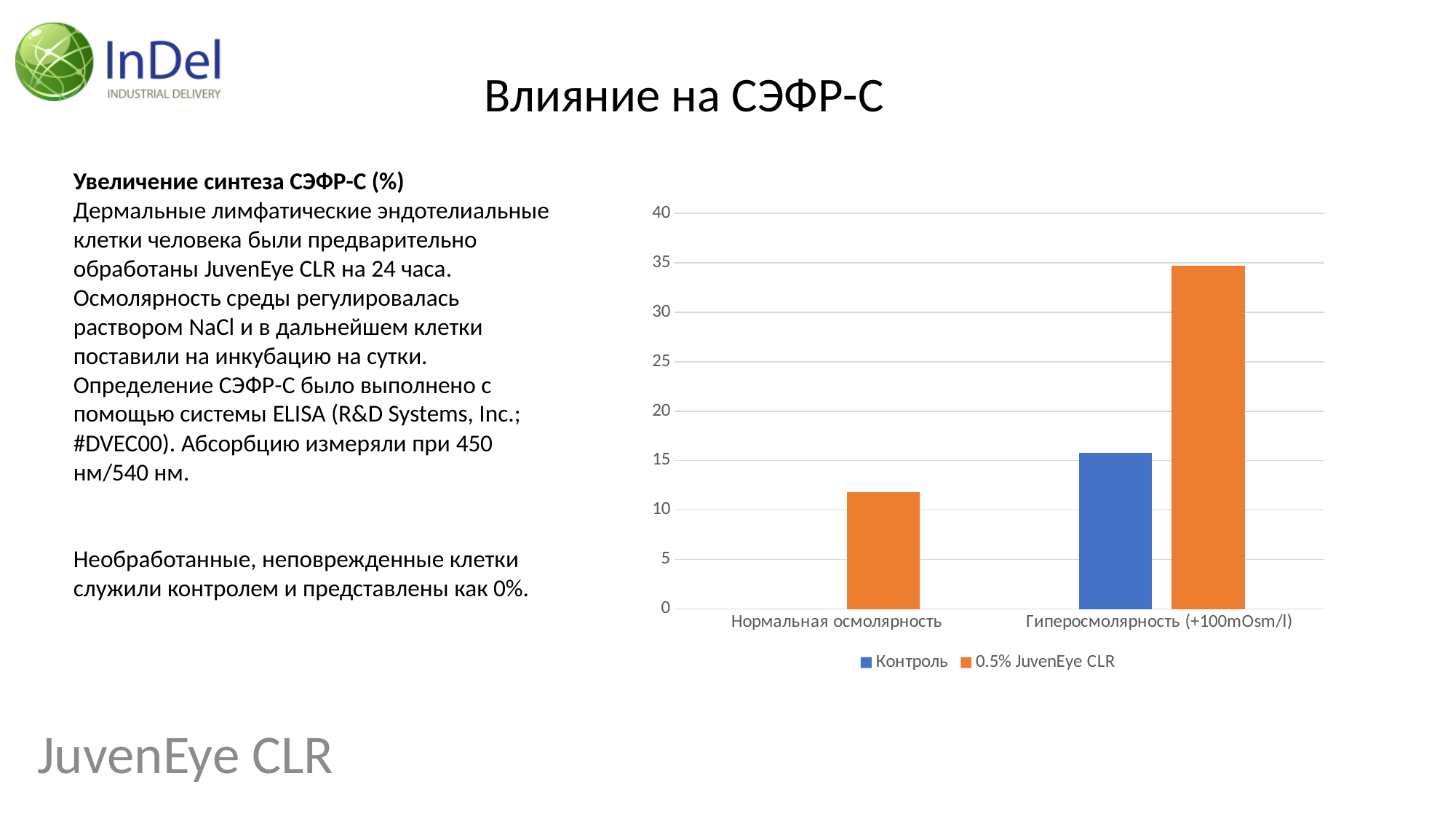
How many series does the chart legend list? 2 Which is larger: Контроль at Гиперосмолярность (+100mOsm/l) or 0.5% JuvenEye CLR at Нормальная осмолярность? Контроль at Гиперосмолярность (+100mOsm/l) In which category does the 0.5% JuvenEye CLR series reach its highest value? Гиперосмолярность (+100mOsm/l) Does the 0.5% JuvenEye CLR series rise or fall from Нормальная осмолярность to Гиперосмолярность (+100mOsm/l)? rise How many categories are shown on the x axis of the chart? 2 What colour represents the Контроль series in the chart? blue What kind of chart is shown on the slide? bar chart Is the value for 0.5% JuvenEye CLR at Нормальная осмолярность greater or less than 15? less At Гиперосмолярность (+100mOsm/l), which series has the larger value, Контроль or 0.5% JuvenEye CLR? 0.5% JuvenEye CLR Is the value for 0.5% JuvenEye CLR at Гиперосмолярность (+100mOsm/l) greater or less than 30? greater Is the value for Контроль at Гиперосмолярность (+100mOsm/l) greater or less than 20? less